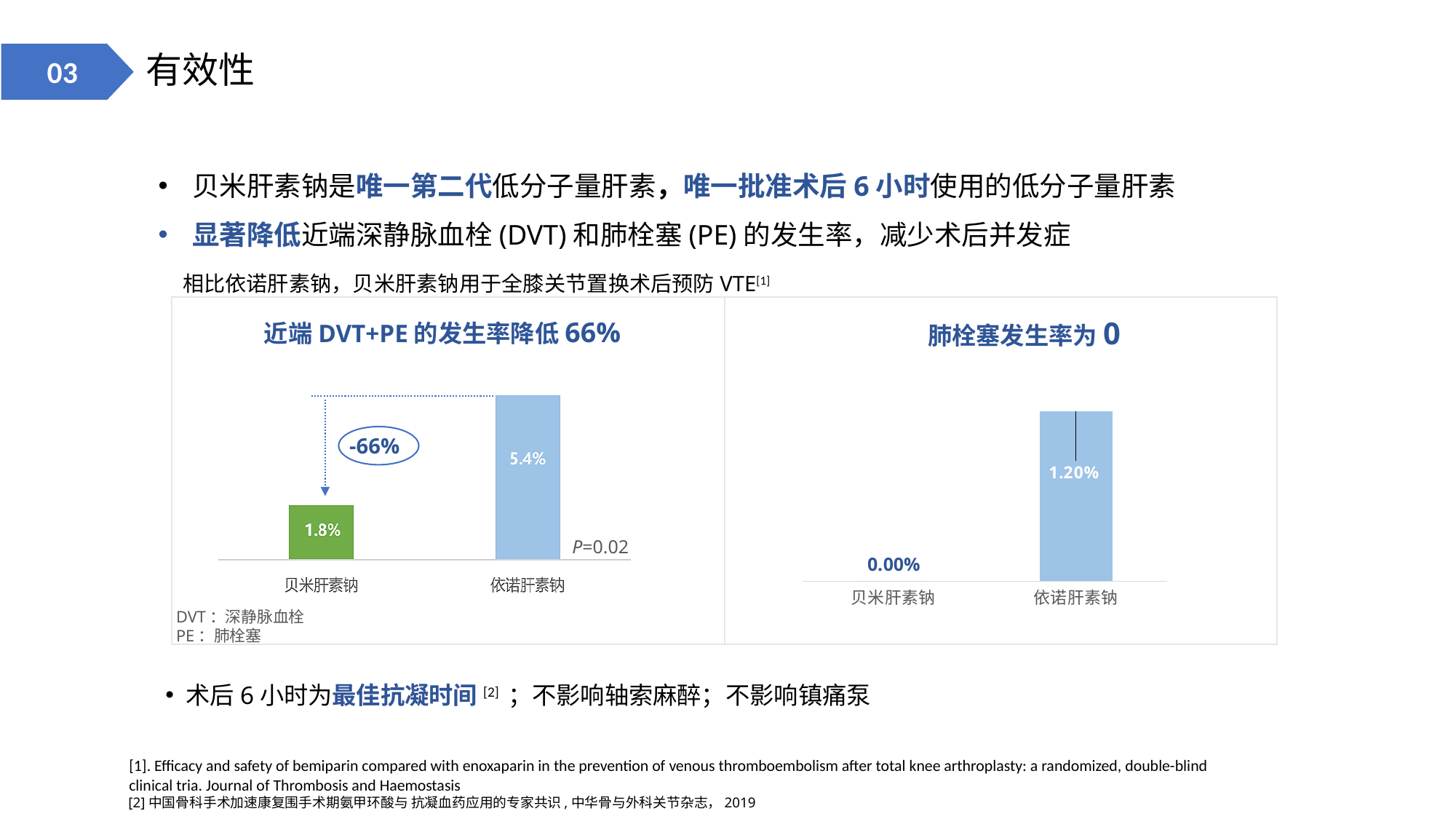
In the left chart titled 近端 DVT+PE 的发生率降低 66%, what percentage reduction is shown in the oval annotation? -66% In the right chart titled 肺栓塞发生率为 0, what is the value for 依诺肝素钠? 1.20% In the right chart titled 肺栓塞发生率为 0, what is the difference between the values for 依诺肝素钠 and 贝米肝素钠? 1.20% In the right chart titled 肺栓塞发生率为 0, what is the value for 贝米肝素钠? 0.00% What type of chart is the right chart titled 肺栓塞发生率为 0? Bar chart In the left chart titled 近端 DVT+PE 的发生率降低 66%, what is the value for 贝米肝素钠? 1.8% In the right chart titled 肺栓塞发生率为 0, which category has the lower value? 贝米肝素钠 In the left chart titled 近端 DVT+PE 的发生率降低 66%, what is the difference between the values for 依诺肝素钠 and 贝米肝素钠? 3.6% In the left chart titled 近端 DVT+PE 的发生率降低 66%, what P value is shown? P=0.02 In the left chart titled 近端 DVT+PE 的发生率降低 66%, which category has the higher value? 依诺肝素钠 In the left chart titled 近端 DVT+PE 的发生率降低 66%, what is the value for 依诺肝素钠? 5.4% How many categories are shown in the left chart titled 近端 DVT+PE 的发生率降低 66%? 2